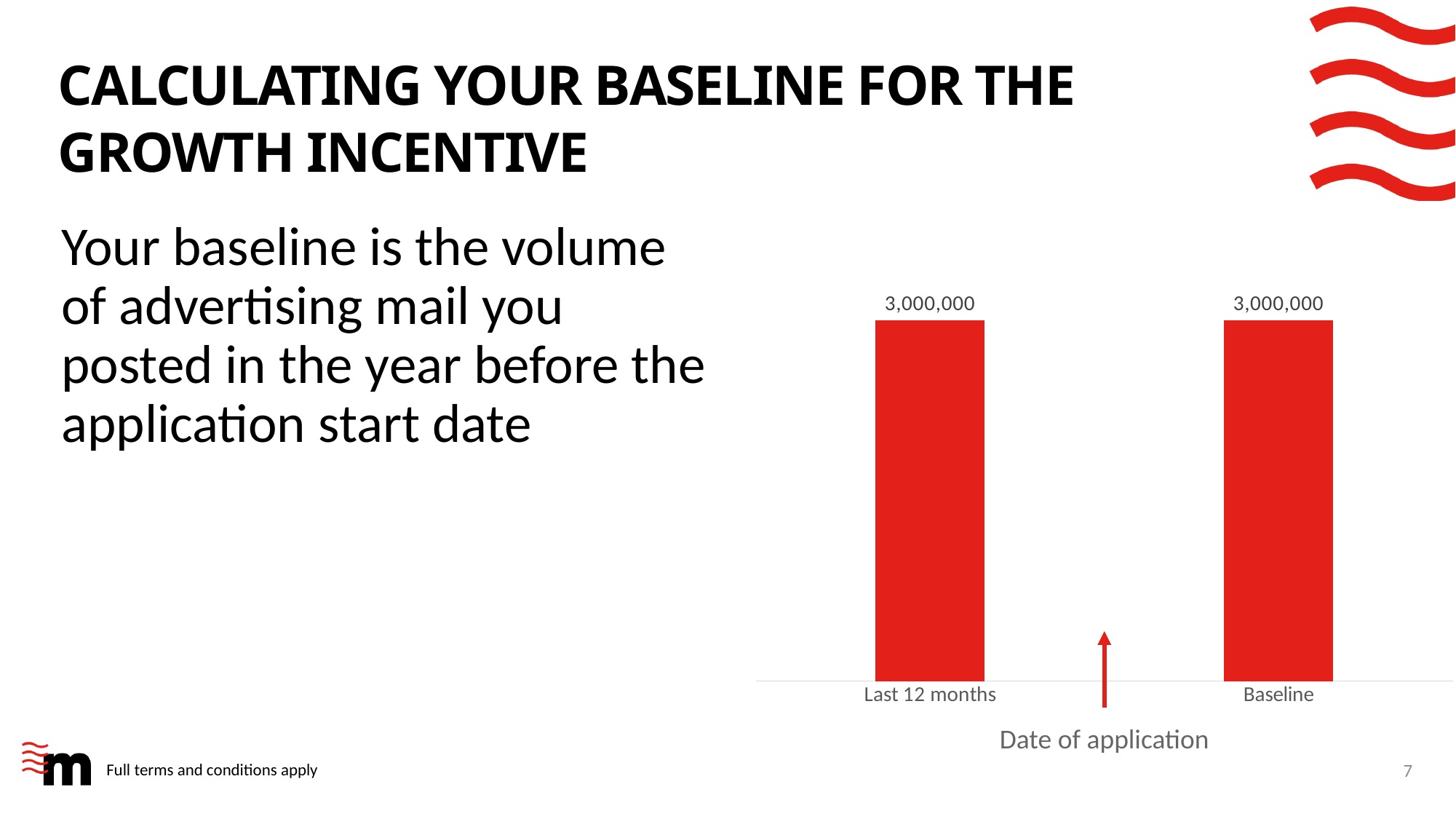
How many bars are plotted in the chart? 2 Is the value for Baseline greater or less than 2,000,000? greater What is the value for Baseline? 3,000,000 What kind of chart is shown on the slide? bar chart What label appears beneath the arrow between the two bars? Date of application What is the value for Last 12 months? 3,000,000 What is the difference between the Last 12 months value and the Baseline value? 0 What are the two category labels on the x axis? Last 12 months, Baseline Are the values for Last 12 months and Baseline equal? Yes